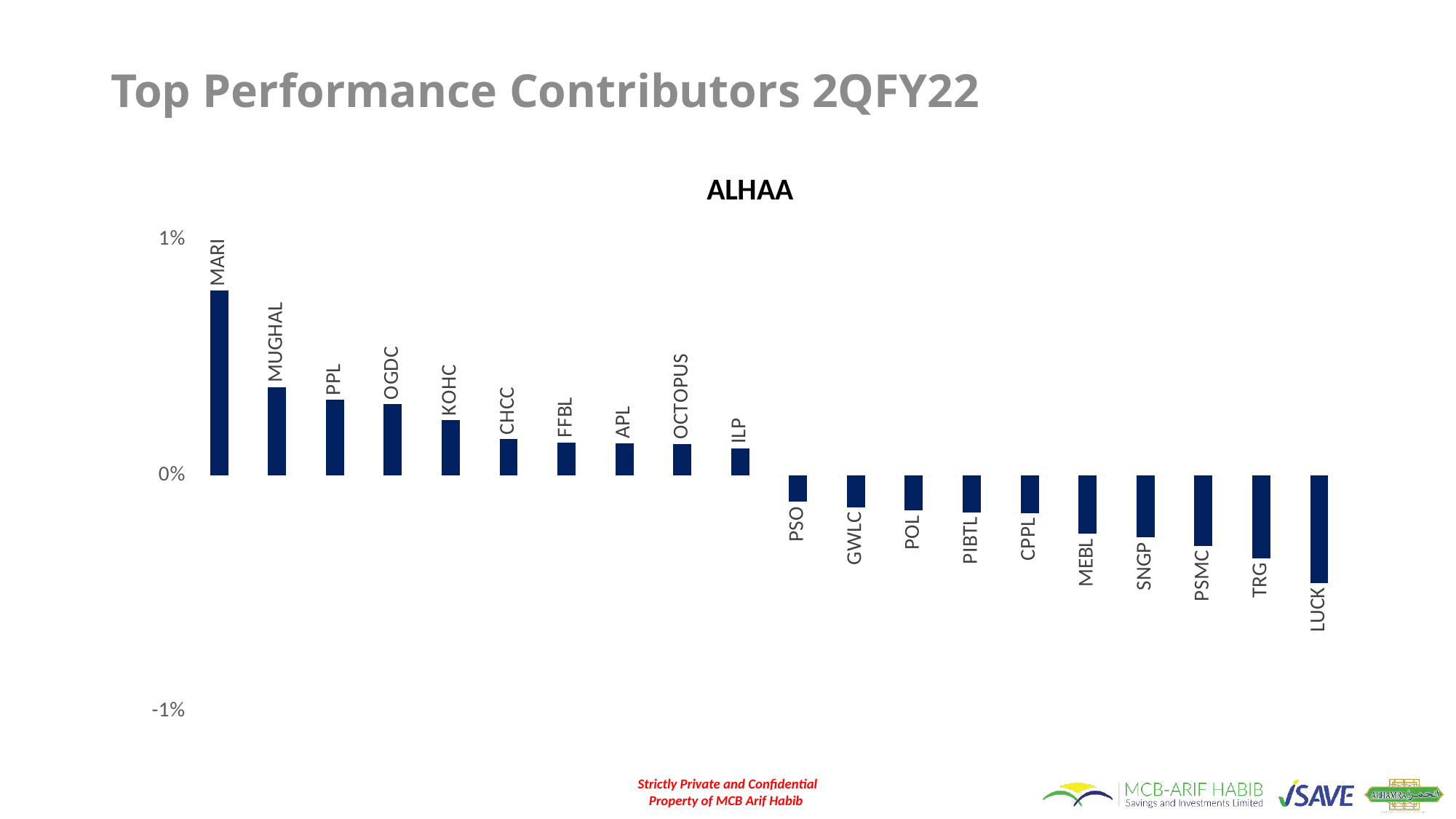
Is the value for LUCK greater or less than 0%? less Which category has the lowest value in the chart? LUCK Is the value for MARI greater or less than 0%? greater What type of chart is shown on the slide? bar chart Which has the larger value, MARI or MUGHAL? MARI Do the values rise or fall moving from left to right along the x axis? fall Which category has the highest value in the chart? MARI How many categories (stocks) are plotted in the chart? 20 Which has the lower value, TRG or LUCK? LUCK Is the value for MARI greater or less than 1%? less What is the title of the chart? ALHAA